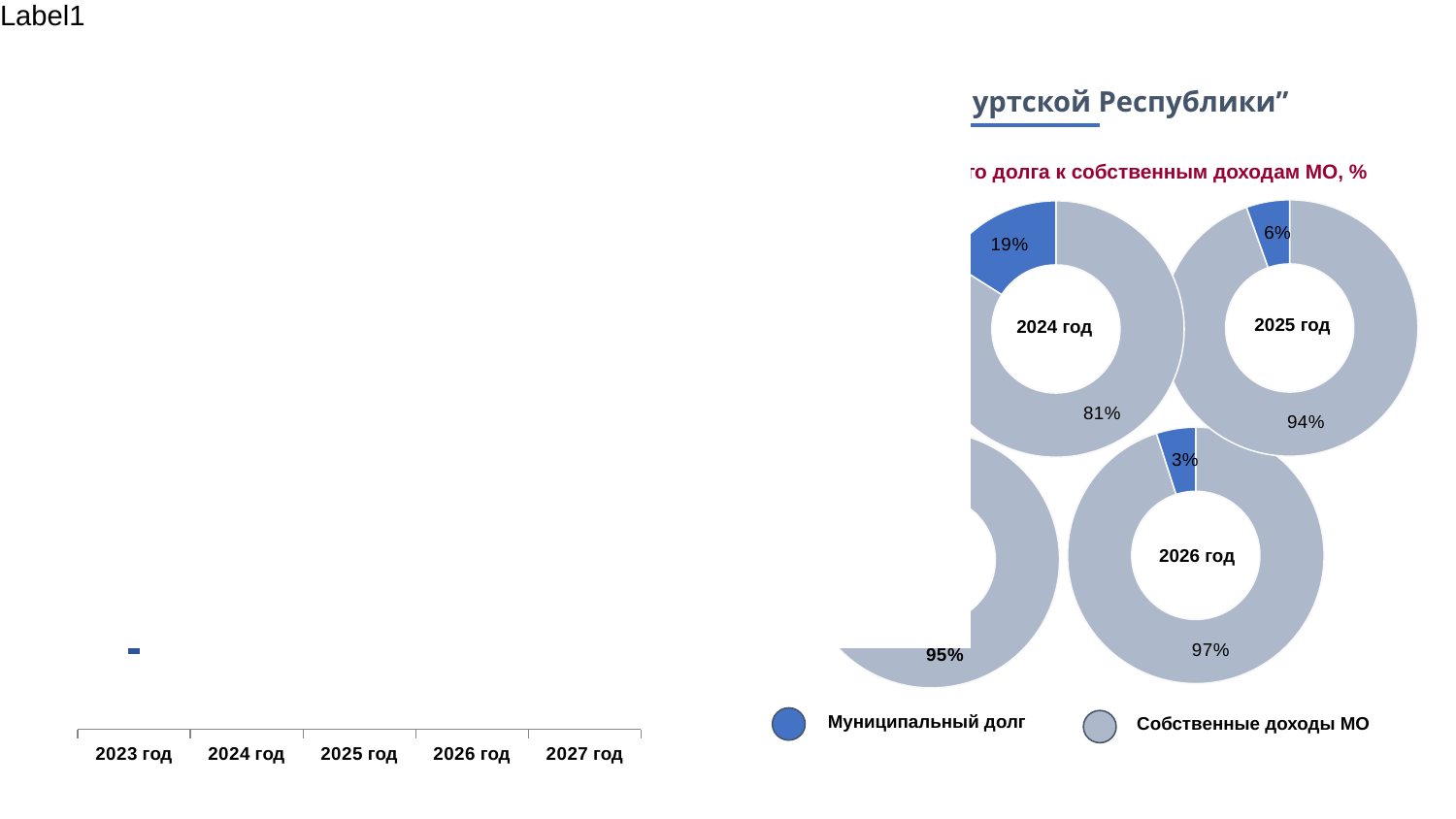
In the 2026 год donut chart, what share is Собственные доходы МО? 97% In the 2024 год donut chart, what share is Собственные доходы МО? 81% What colour represents Муниципальный долг in the donut charts' legend? Blue Among the 2024, 2025 and 2026 donut charts, which year has the smallest share of Муниципальный долг? 2026 год How many series does the legend of the donut charts list? 2 In the 2024 год donut chart, what share is Муниципальный долг? 19% In the 2025 год donut chart, what share is Собственные доходы МО? 94% In the 2026 год donut chart, what share is Муниципальный долг? 3% Is the Муниципальный долг share larger in the 2025 год donut or the 2026 год donut? 2025 год In the 2025 год donut chart, what share is Муниципальный долг? 6% What is the difference between the Муниципальный долг share in the 2024 год donut and in the 2025 год donut? 13% Among the 2024, 2025 and 2026 donut charts, which year has the largest share of Муниципальный долг? 2024 год